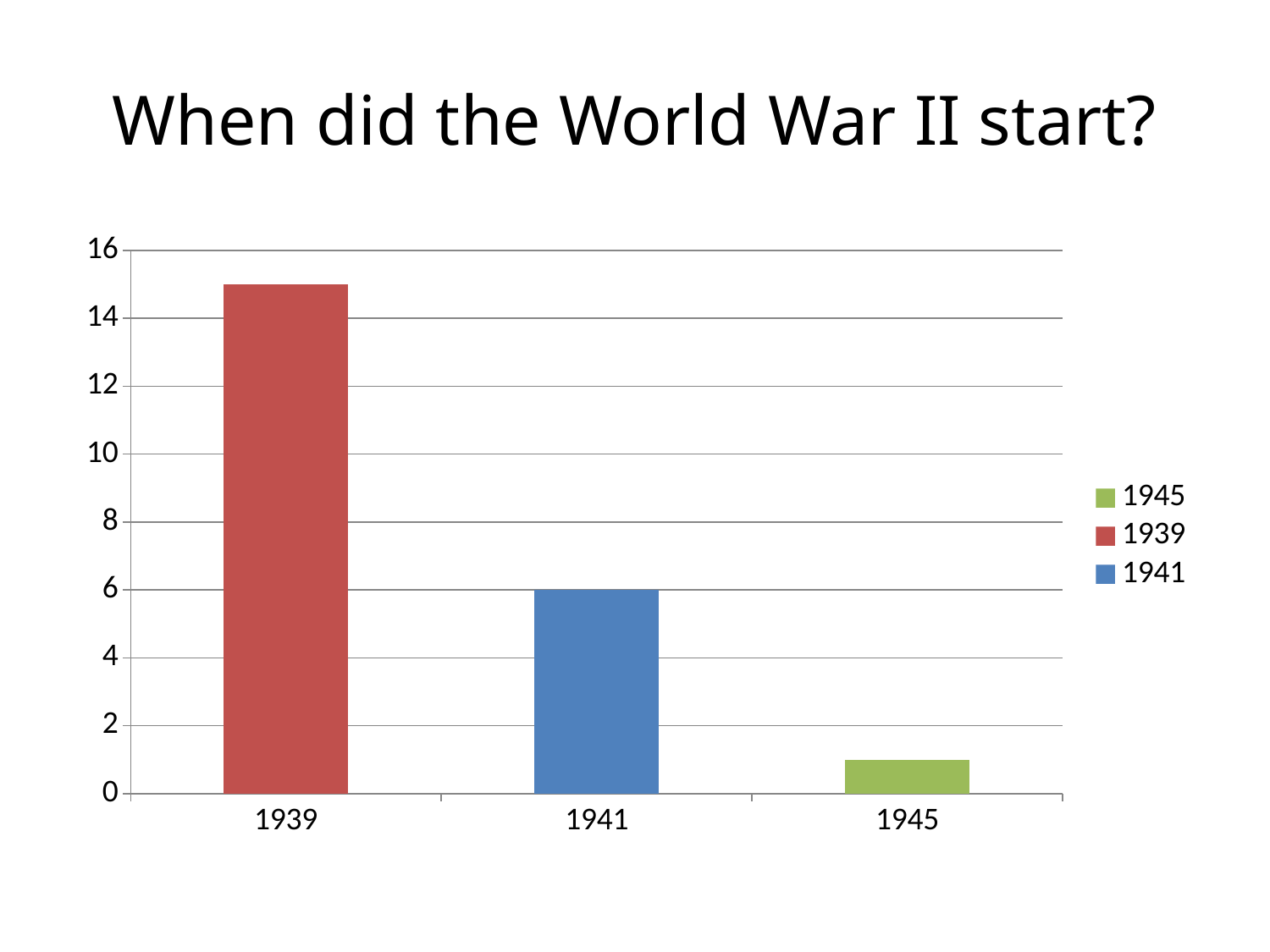
How many entries does the legend list? 3 What is the value for 1941? 6 Is the value for 1941 greater or less than 10? less Is the value for 1939 greater or less than 14? greater How many categories are shown on the x axis? 3 Which is larger, the value for 1941 or the value for 1945? 1941 Is the value for 1945 greater or less than 2? less What kind of chart is shown on the slide? bar chart Do the values rise or fall from left to right along the x axis? fall Which category has the lowest bar? 1945 Which category has the highest bar? 1939 Which is larger, the value for 1939 or the value for 1941? 1939